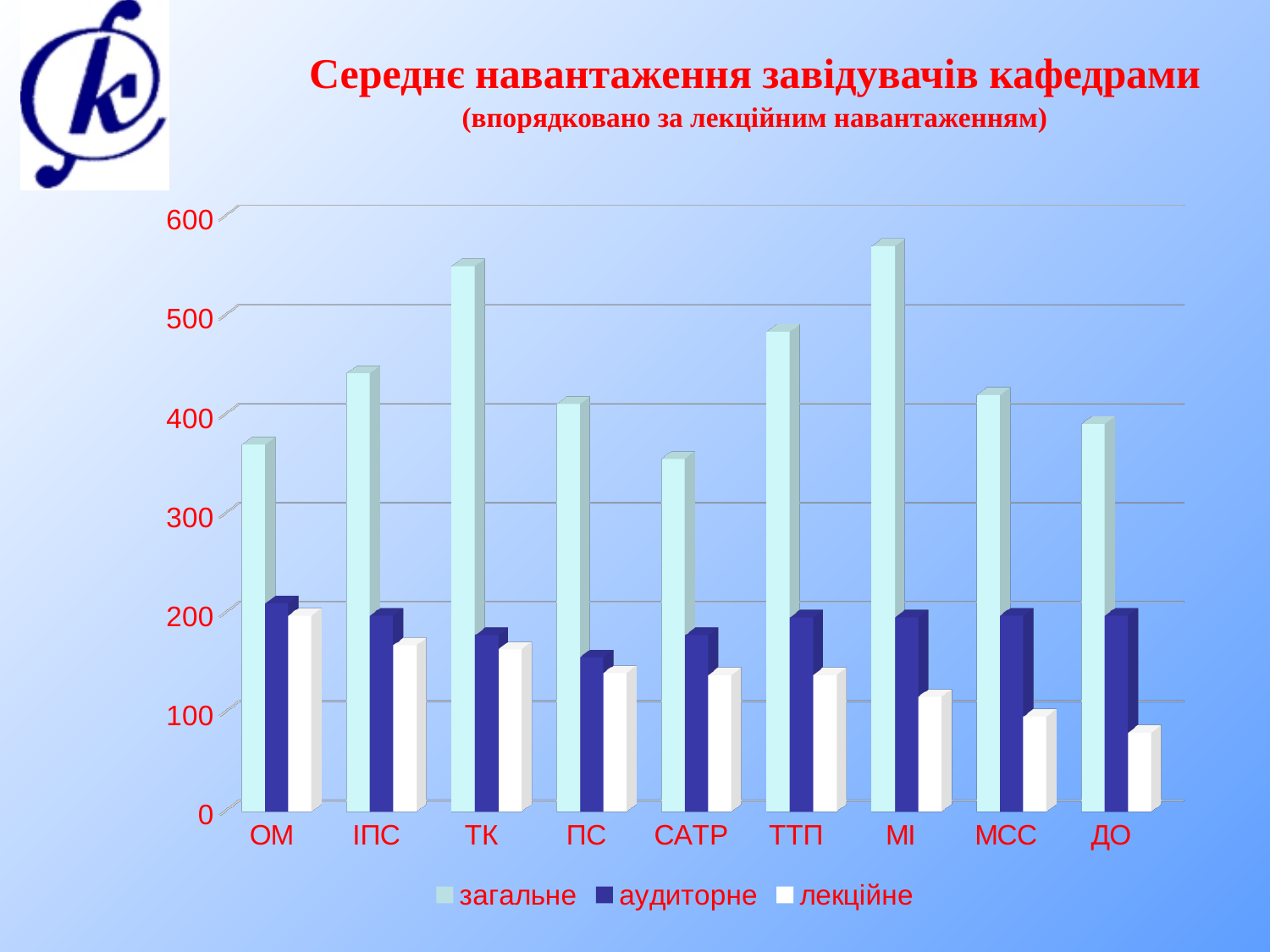
Is the загальне value for ТК greater or less than 500? greater How many series does the legend list? 3 Is the загальне value for ОМ greater or less than 400? less Which is larger: the загальне value for ТК or for ІПС? ТК Which category has the highest value for the series загальне? МІ Do the лекційне values rise or fall moving from ОМ to ДО along the x axis? fall Which category has the highest value for the series лекційне? ОМ Is the лекційне value for ДО greater or less than 100? less Which category has the lowest value for the series лекційне? ДО Which category has the lowest value for the series аудиторне? ПС What kind of chart is shown on the slide? bar chart How many categories (departments) are shown along the x axis? 9